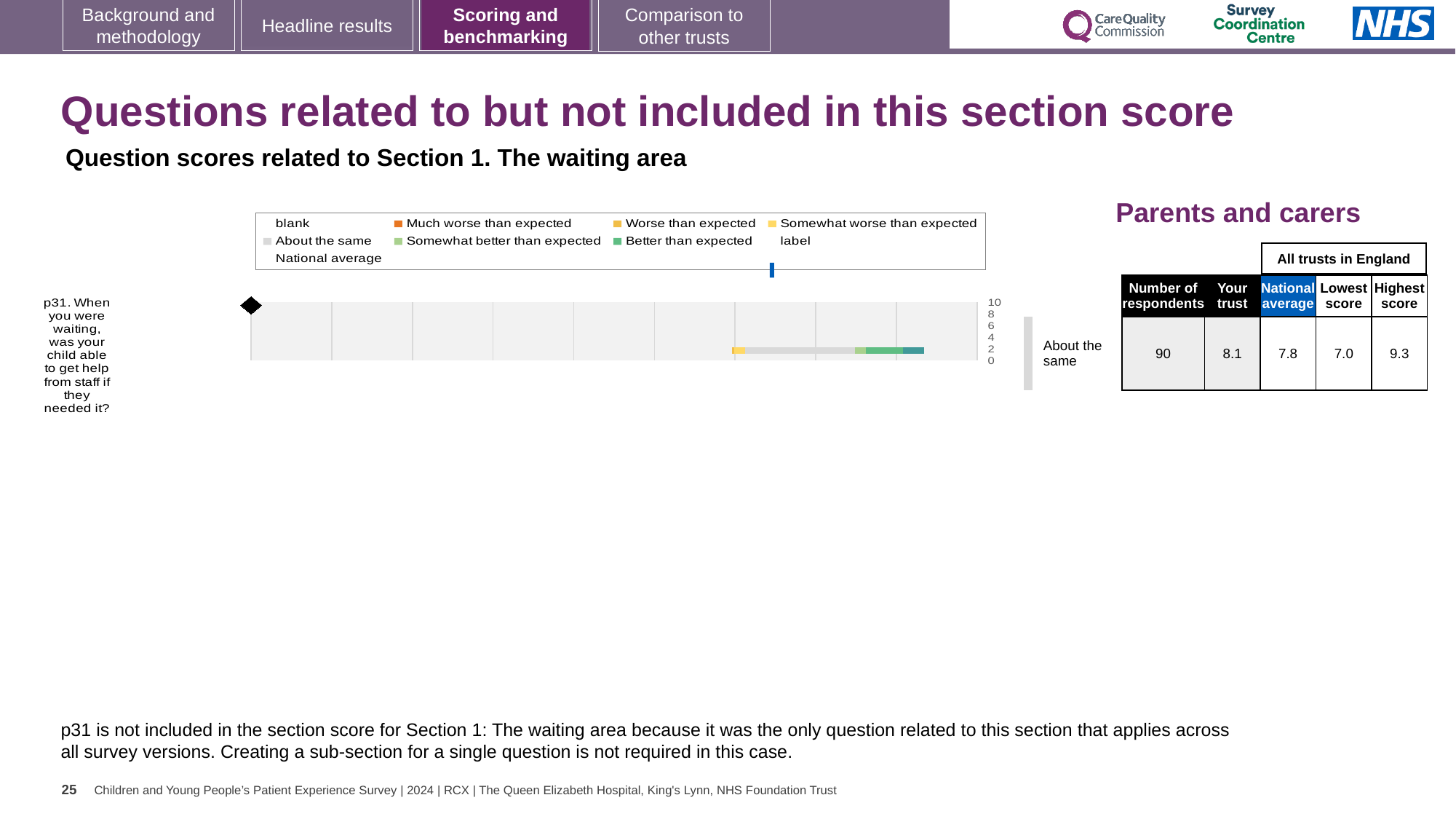
In the table beside the chart, what is the highest score among all trusts in England for p31? 9.3 What is the difference between the highest and lowest scores for p31 in the table? 2.3 How many questions are plotted in the chart? 1 In the table beside the chart, what is the 'Your trust' score for p31? 8.1 In the table beside the chart, how many respondents answered p31? 90 Which is larger for p31, the 'Your trust' score or the national average? Your trust Which benchmarking category is the trust's result for p31 placed in? About the same What kind of chart is shown for question p31? bar chart In the table beside the chart, what is the lowest score among all trusts in England for p31? 7.0 In the table beside the chart, what is the national average score for p31? 7.8 Which legend entry is shown in orange? Much worse than expected Which question is plotted in the chart? p31. When you were waiting, was your child able to get help from staff if they needed it?